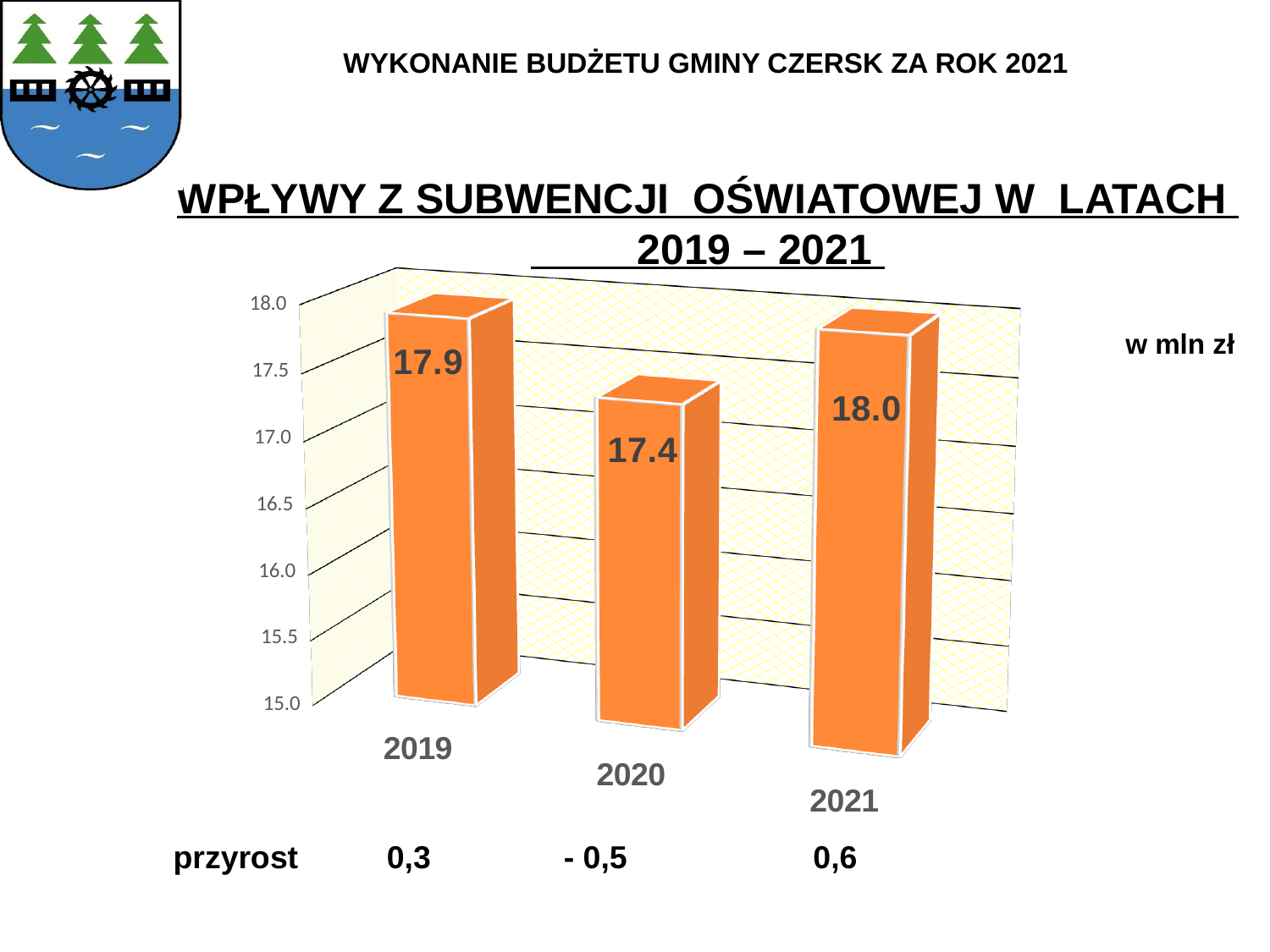
What is the difference between the values for 2021 and 2020? 0.6 How many years are shown on the chart? 3 What unit is indicated for the chart values? w mln zł Which year has the lowest value? 2020 Is the value for 2020 greater or less than 17.0? greater Which is larger, the value for 2019 or the value for 2020? 2019 What is the difference between the values for 2019 and 2020? 0.5 What kind of chart is shown on the slide? bar chart What is the value for 2020? 17.4 Which year has the highest value? 2021 What is the value for 2021? 18.0 What is the value for 2019? 17.9